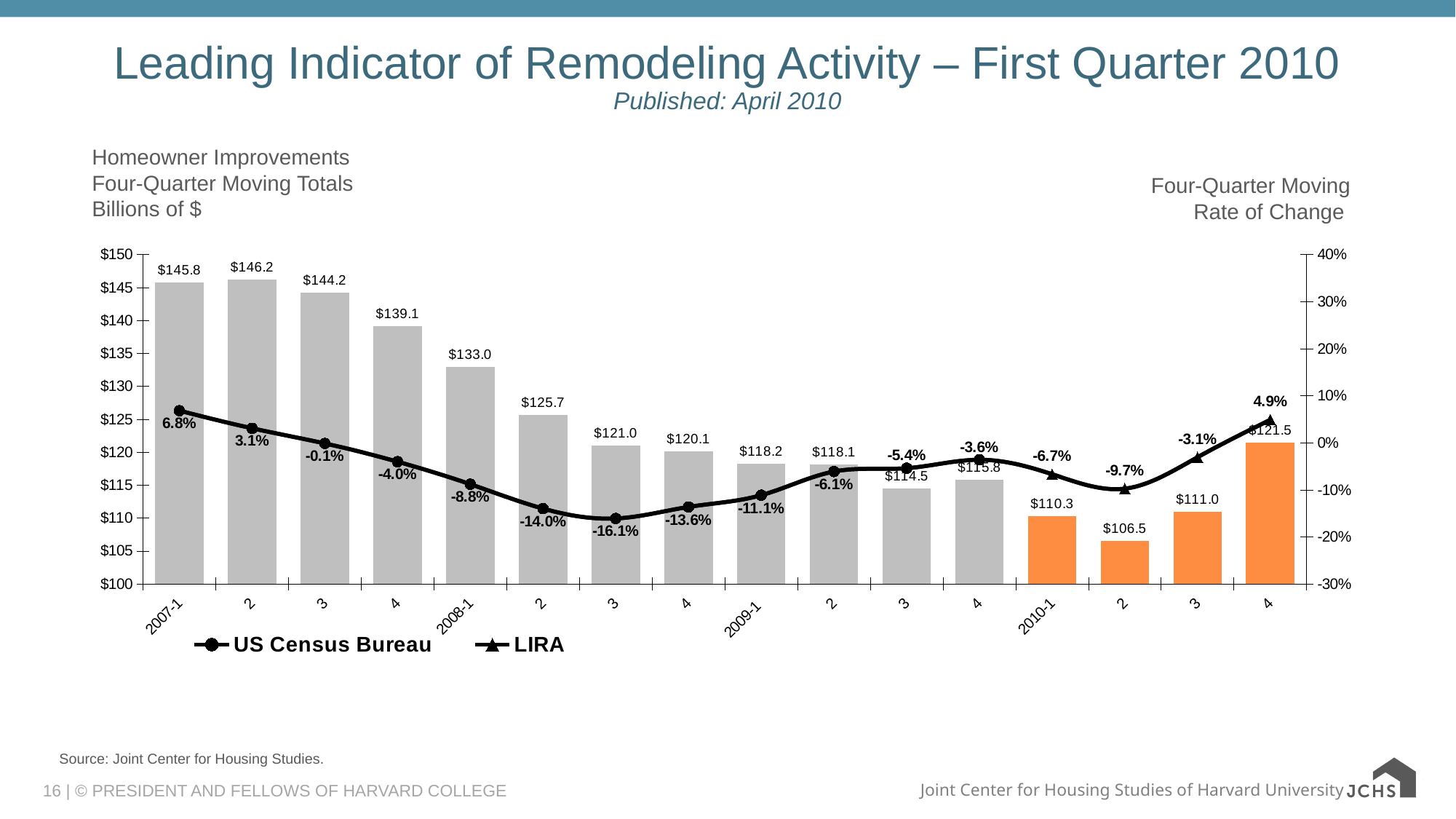
Which quarter has the lowest four-quarter moving rate of change on the line? 2008-3 What is the difference between the homeowner improvements totals for 2007-1 and 2010-2? $39.3 How many bars (quarters) are plotted in the chart? 16 What is the homeowner improvements four-quarter moving total for 2007-1? $145.8 How many series does the legend list? 2 Which quarter has the lowest homeowner improvements four-quarter moving total? 2010-2 What are the two series named in the legend? US Census Bureau and LIRA What is the four-quarter moving rate of change shown for 2008-3? -16.1% What kind of chart is used for the homeowner improvements totals? Bar chart Which is larger, the homeowner improvements total for 2009-3 or for 2009-4? 2009-4 Which quarter has the highest homeowner improvements four-quarter moving total? 2007-2 What is the homeowner improvements value shown for the last bar, 2010-4? $121.5